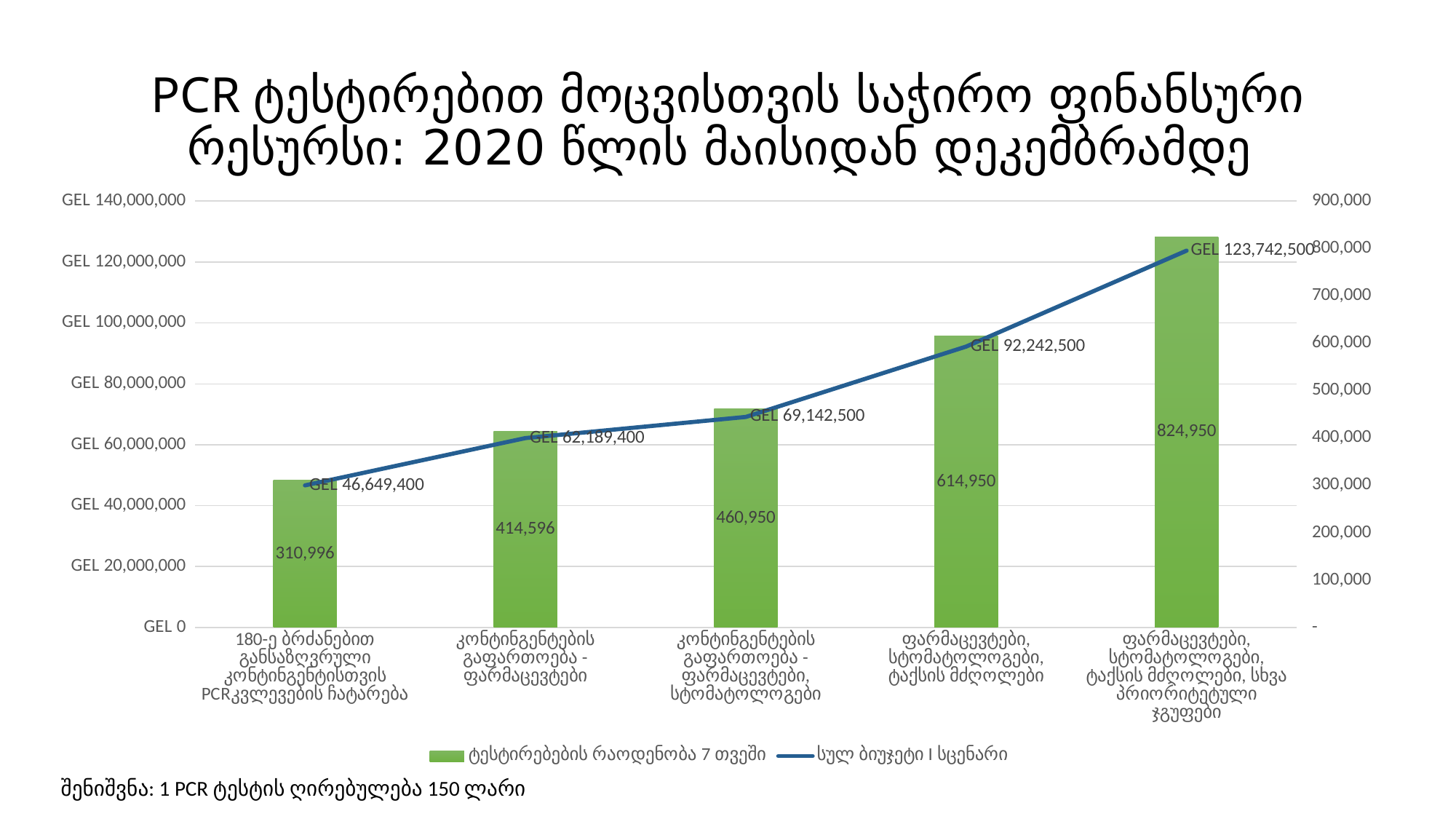
How many series does the legend list? 2 What is the number of tests for the first category, "180-ე ბრძანებით განსაზღვრული კონტინგენტისთვის PCR კვლევების ჩატარება"? 310,996 What is the number of tests (ტესტირებების რაოდენობა 7 თვეში) for the category "ფარმაცევტები, სტომატოლოგები, ტაქსის მძღოლები"? 614,950 What is the total budget (სულ ბიუჯეტი I სცენარი) for the category "კონტინგენტების გაფართოება - ფარმაცევტები"? GEL 62,189,400 What kind of chart is shown on the slide? Combined bar and line chart Which category has the lowest number of tests? 180-ე ბრძანებით განსაზღვრული კონტინგენტისთვის PCR კვლევების ჩატარება Which category has the highest total budget (სულ ბიუჯეტი I სცენარი)? ფარმაცევტები, სტომატოლოგები, ტაქსის მძღოლები, სხვა პრიორიტეტული ჯგუფები Do the total budget values (სულ ბიუჯეტი I სცენარი) rise or fall from left to right along the x axis? Rise What is the difference in total budget between "კონტინგენტების გაფართოება - ფარმაცევტები, სტომატოლოგები" and "კონტინგენტების გაფართოება - ფარმაცევტები"? GEL 6,953,100 How many categories are shown on the x axis of the chart? 5 What is the difference in the number of tests between "ფარმაცევტები, სტომატოლოგები, ტაქსის მძღოლები, სხვა პრიორიტეტული ჯგუფები" and "ფარმაცევტები, სტომატოლოგები, ტაქსის მძღოლები"? 210,000 Which has a larger number of tests: "კონტინგენტების გაფართოება - ფარმაცევტები" or "კონტინგენტების გაფართოება - ფარმაცევტები, სტომატოლოგები"? კონტინგენტების გაფართოება - ფარმაცევტები, სტომატოლოგები